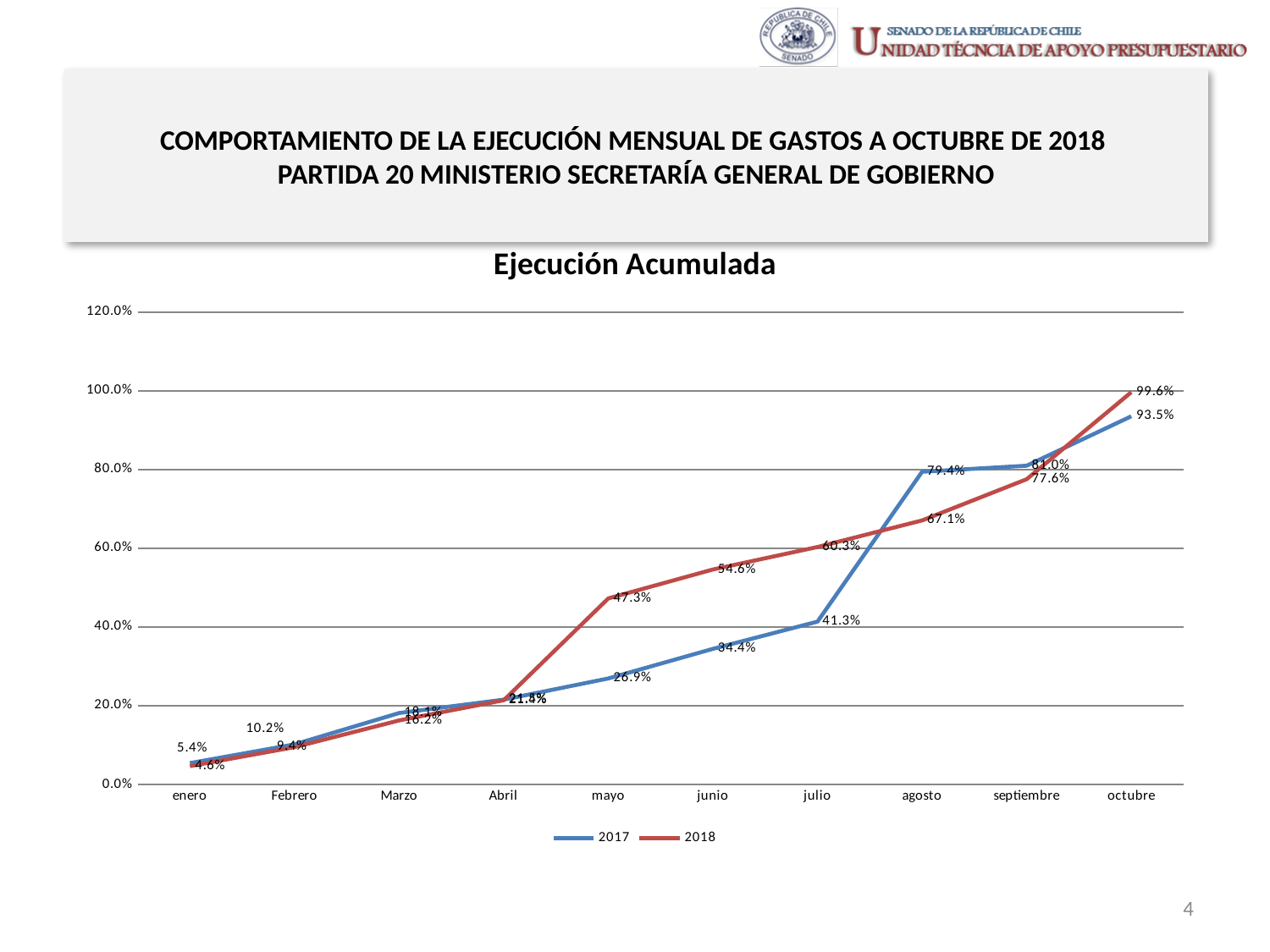
What is the value for 2017 in octubre? 93.5% Which series has the larger value in agosto, 2017 or 2018? 2017 What is the value for 2018 in mayo? 47.3% In which month does the 2018 series reach its highest value? octubre Do the values of the 2017 series rise or fall from enero to octubre? rise What is the value for 2018 in octubre? 99.6% How many months are shown on the x axis? 10 What is the title of the chart? Ejecución Acumulada How many series does the legend list? 2 What is the value for 2017 in agosto? 79.4% What type of chart is shown on the slide? line chart What is the difference between the 2018 and 2017 values in julio? 19.0%